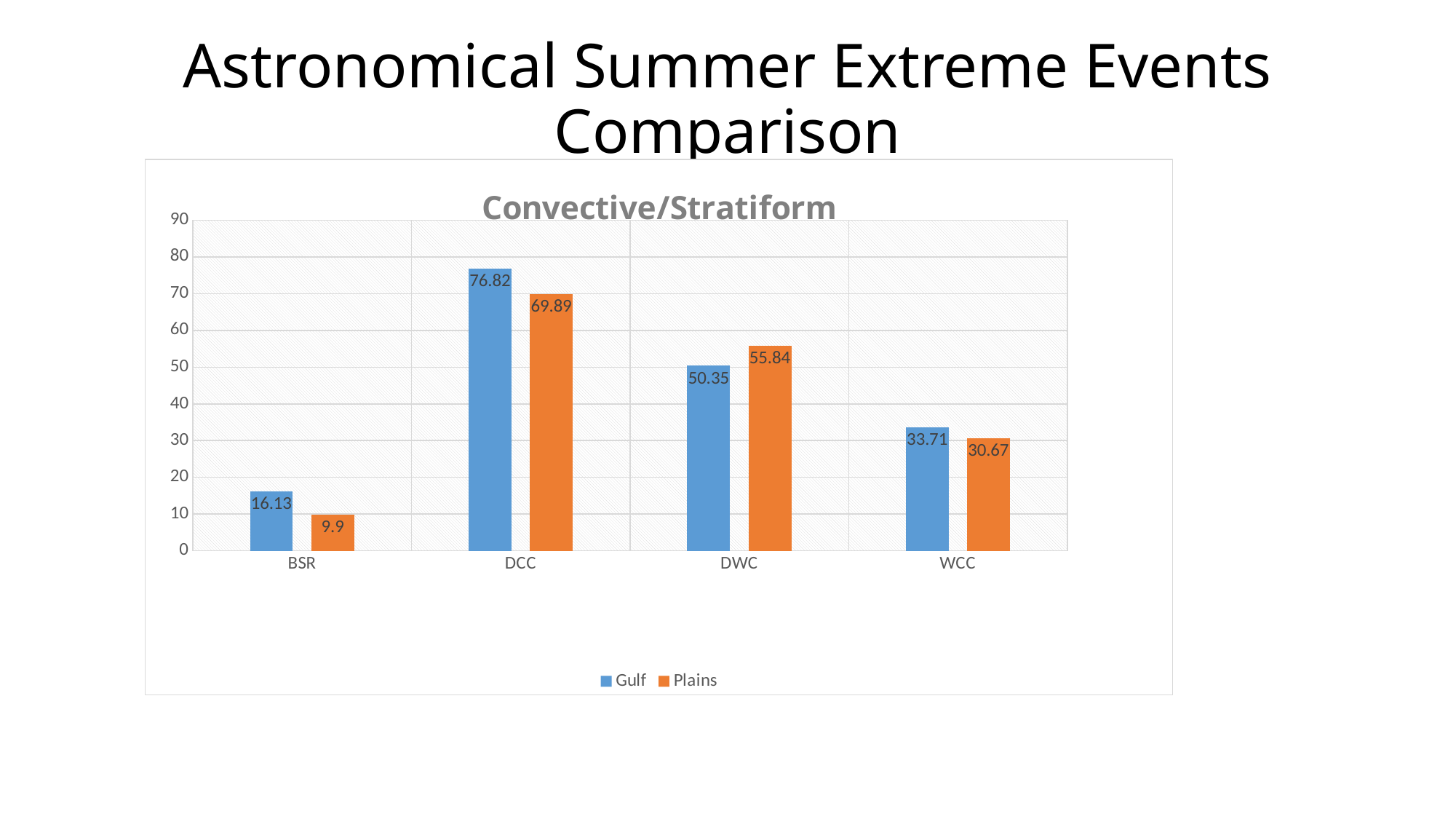
What is the Plains value for DWC? 55.84 Which category has the lowest Plains value? BSR What kind of chart is shown? Bar chart What is the Gulf value for DCC? 76.82 What is the title of the chart? Convective/Stratiform What is the Gulf value for WCC? 33.71 How many categories are shown on the x axis? 4 How many series does the legend list? 2 Which is larger for DWC, the Gulf value or the Plains value? Plains What is the difference between the Gulf and Plains values for DCC? 6.93 Which category has the highest Gulf value? DCC What is the Plains value for BSR? 9.9